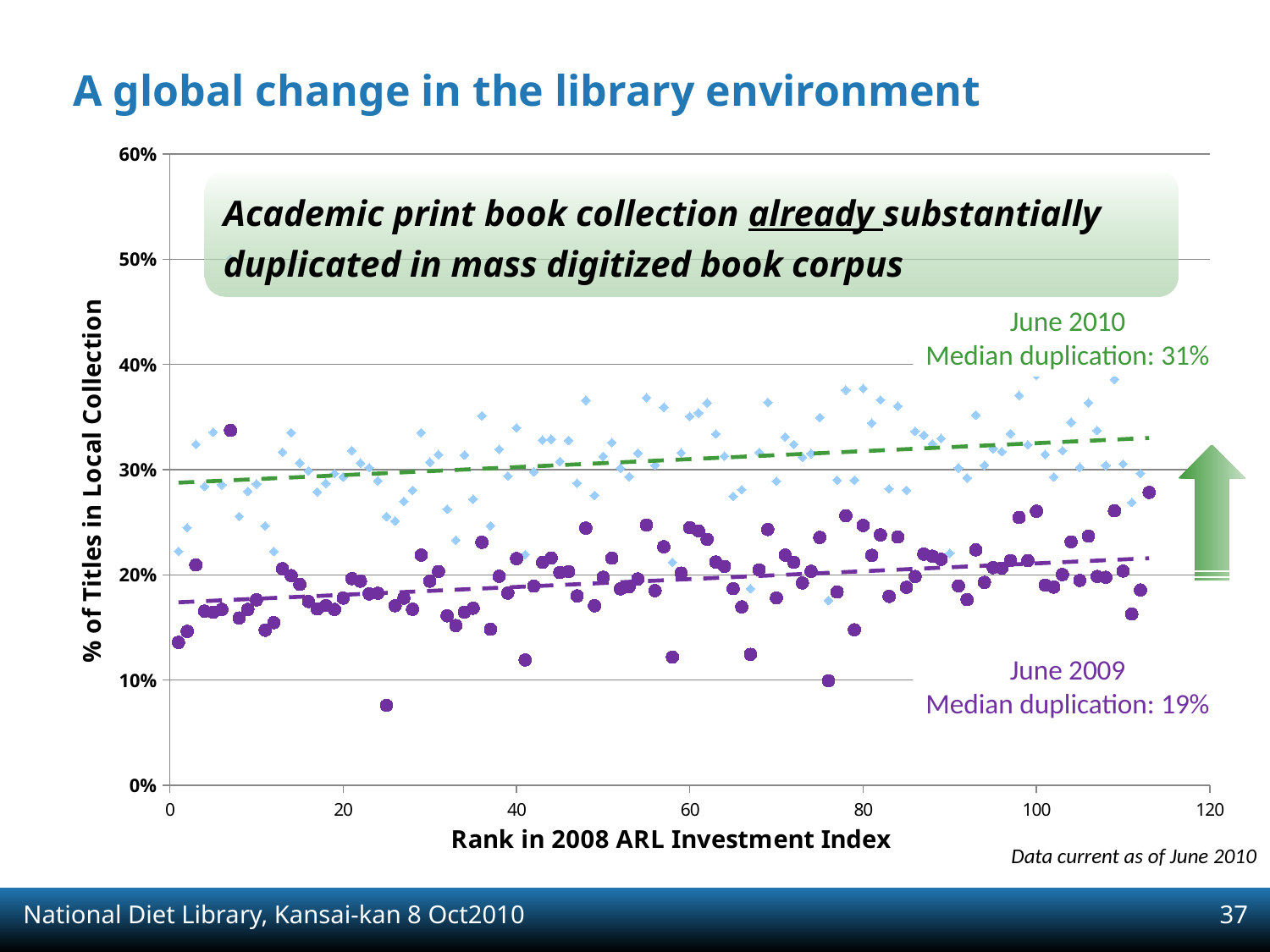
Is the highest June 2009 value greater or less than 30%? greater What is the label of the vertical axis? % of Titles in Local Collection What is the median duplication for June 2009? 19% What kind of chart is shown on the slide? Scatter chart Is the lowest June 2009 value greater or less than 10%? less By how many percentage points does the June 2010 median duplication exceed the June 2009 median duplication? 12 percentage points Do the dashed trend lines rise or fall as the rank in the 2008 ARL Investment Index increases? Rise Which series has the higher median duplication, June 2010 or June 2009? June 2010 What is the maximum value shown on the vertical axis? 60% What is the median duplication for June 2010? 31% What is the label of the horizontal axis? Rank in 2008 ARL Investment Index How many data series are plotted on the chart? 2